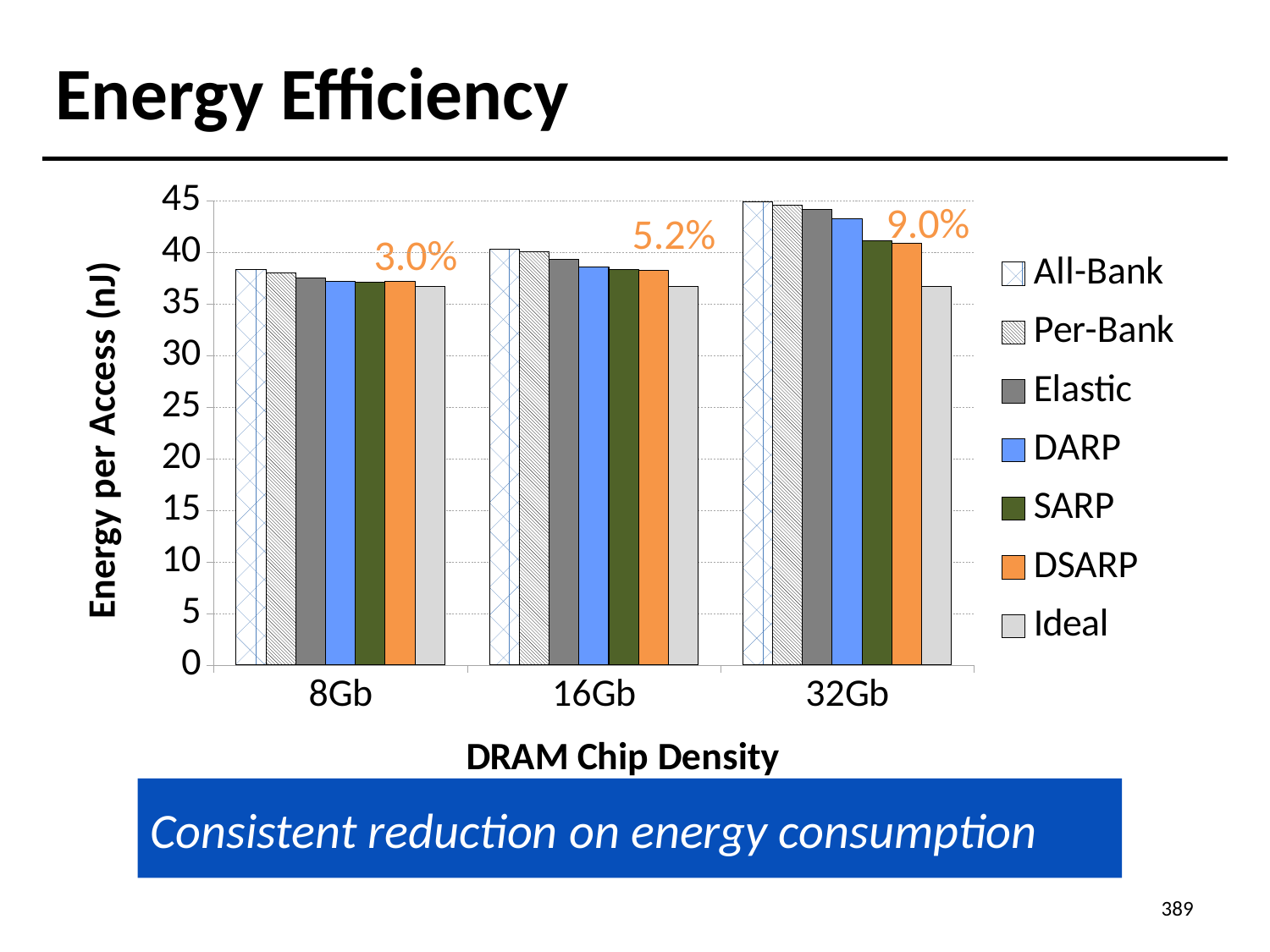
Is the All-Bank value at 32Gb greater or less than 40? greater Is the Ideal value at 16Gb greater or less than 40? less Which DRAM chip density has the highest All-Bank energy per access? 32Gb What percentage label is printed above the 32Gb group of bars? 9.0% Does the All-Bank energy per access rise or fall as DRAM chip density increases from 8Gb to 32Gb? rise What percentage label is printed above the 8Gb group of bars? 3.0% How many DRAM chip density categories are shown on the x axis? 3 How many series does the legend list? 7 Which series has the lowest energy per access at 32Gb? Ideal What percentage label is printed above the 16Gb group of bars? 5.2% Is the All-Bank value at 8Gb greater or less than 35? greater What kind of chart is shown on the slide? bar chart